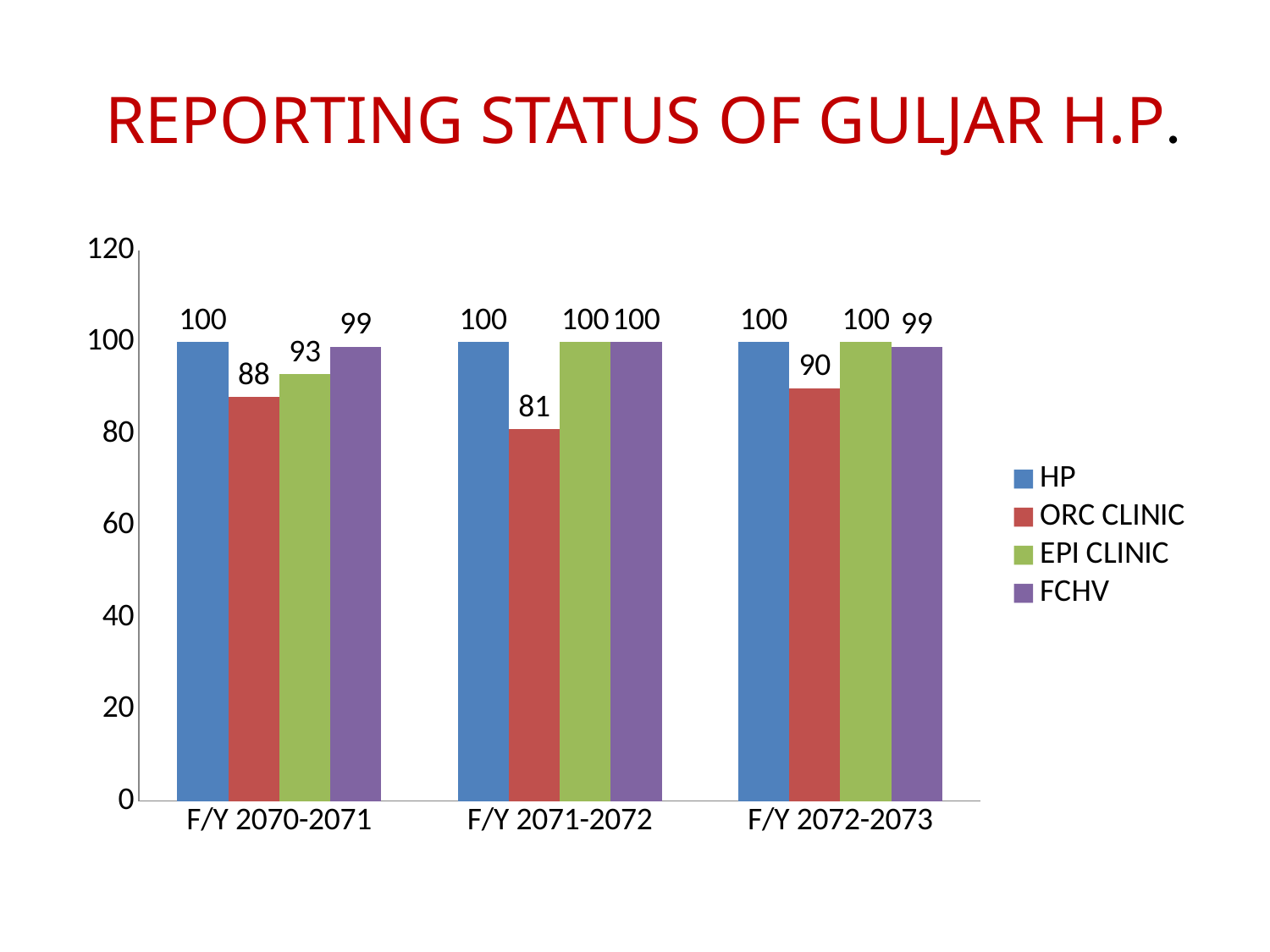
What is the value for HP in F/Y 2071-2072? 100 What is the value for ORC CLINIC in F/Y 2071-2072? 81 What is the value for FCHV in F/Y 2072-2073? 99 What is the difference between the HP and ORC CLINIC values in F/Y 2072-2073? 10 What is the title of the slide? REPORTING STATUS OF GULJAR H.P. In which fiscal year is the ORC CLINIC value lowest? F/Y 2071-2072 How many fiscal year categories are shown on the x axis? 3 What kind of chart is shown on the slide? Bar chart How many series does the legend list? 4 Which is larger in F/Y 2070-2071, the EPI CLINIC value or the ORC CLINIC value? EPI CLINIC What is the value for EPI CLINIC in F/Y 2070-2071? 93 Which series has the lowest value in F/Y 2070-2071? ORC CLINIC